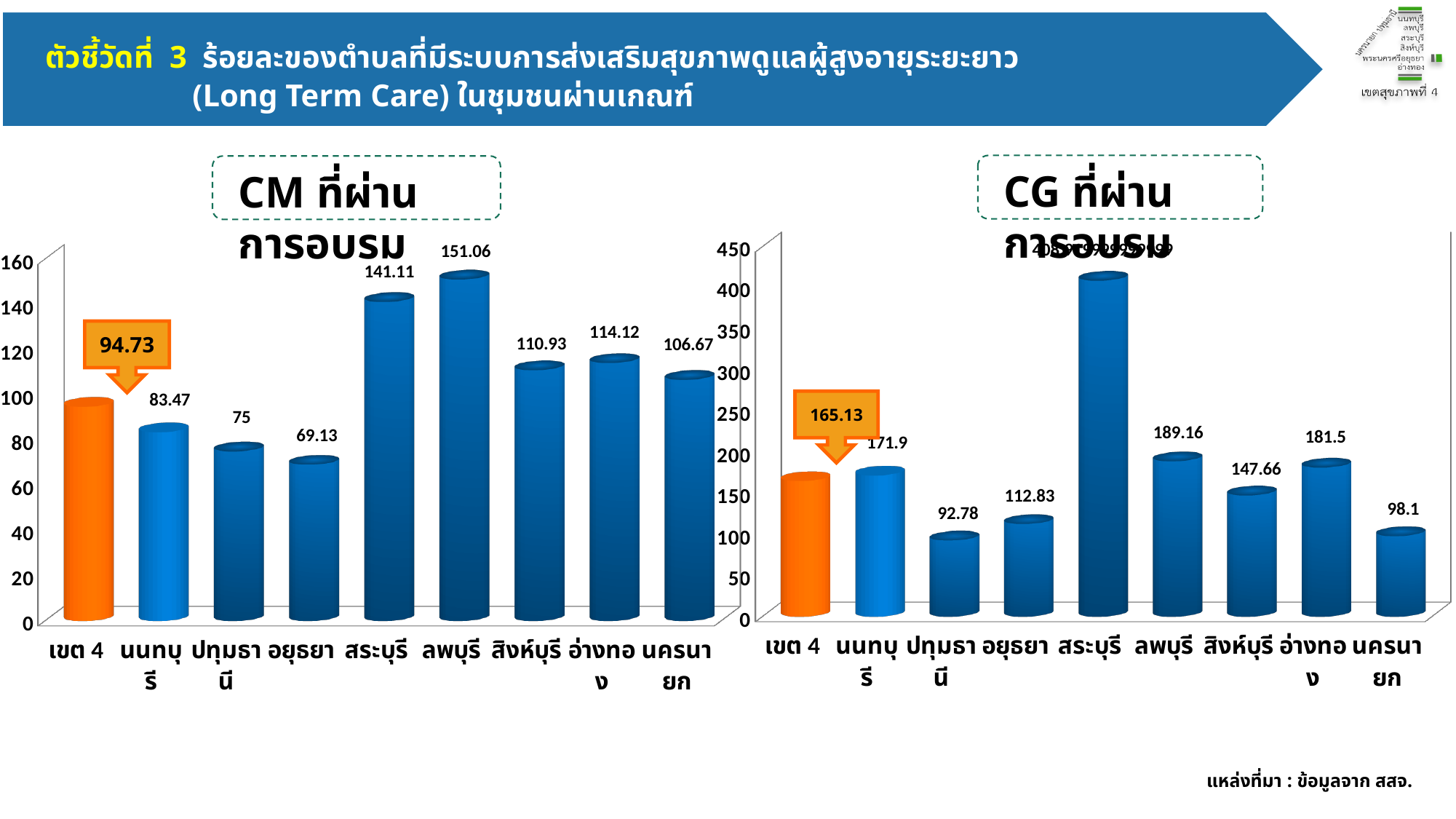
In the CM ที่ผ่านการอบรม chart on the left, which category has the lowest value? อยุธยา What kind of chart is the CM ที่ผ่านการอบรม chart on the left? Bar chart In the CG ที่ผ่านการอบรม chart on the right, which category has the highest value? สระบุรี In the CG ที่ผ่านการอบรม chart on the right, what is the value for อ่างทอง? 181.5 In the CM ที่ผ่านการอบรม chart on the left, what is the value for อยุธยา? 69.13 In the CM ที่ผ่านการอบรม chart on the left, what is the value for ลพบุรี? 151.06 In the CM ที่ผ่านการอบรม chart on the left, which category has the highest value? ลพบุรี How many categories are shown on the x axis of the CG ที่ผ่านการอบรม chart on the right? 9 In the CM ที่ผ่านการอบรม chart on the left, what is the difference between the values for สระบุรี and ปทุมธานี? 66.11 In the CG ที่ผ่านการอบรม chart on the right, which is larger, the value for นนทบุรี or the value for ลพบุรี? ลพบุรี In the CM ที่ผ่านการอบรม chart on the left, what value is shown in the callout above the เขต 4 bar? 94.73 In the CG ที่ผ่านการอบรม chart on the right, which category has the lowest value? ปทุมธานี